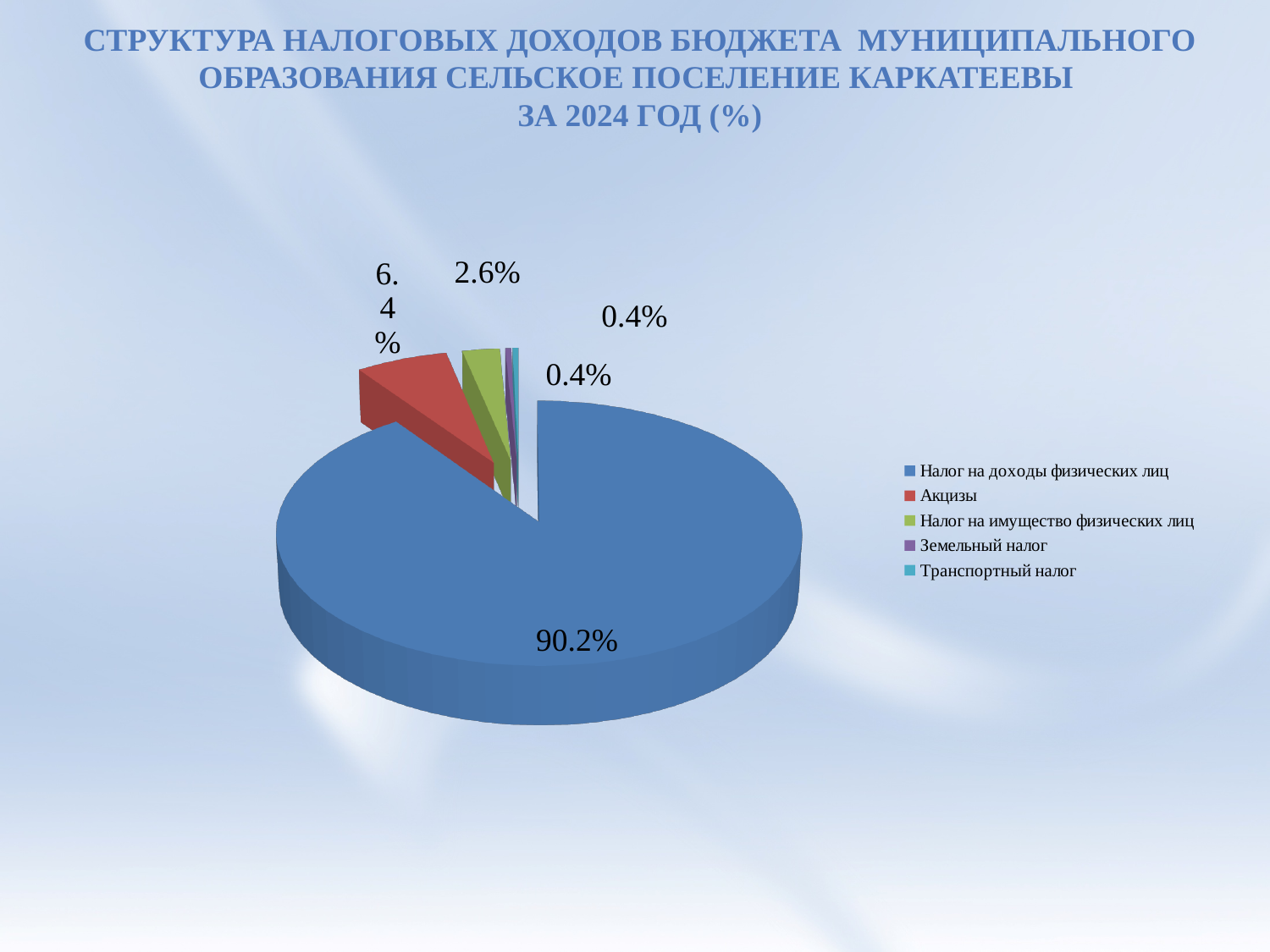
What share of tax revenue does Налог на доходы физических лиц account for? 90.2% What is the value shown for Земельный налог? 0.4% What kind of chart is shown on the slide? pie chart What colour is the slice for Акцизы? red What is the value shown for Транспортный налог? 0.4% Which category has the largest share of the pie? Налог на доходы физических лиц What is the value shown for Акцизы? 6.4% What is the difference between the share for Налог на доходы физических лиц and the share for Акцизы? 83.8% Which is larger, the share for Акцизы or the share for Налог на имущество физических лиц? Акцизы What is the difference between the share for Акцизы and the share for Налог на имущество физических лиц? 3.8% What is the value shown for Налог на имущество физических лиц? 2.6% How many categories does the legend list? 5